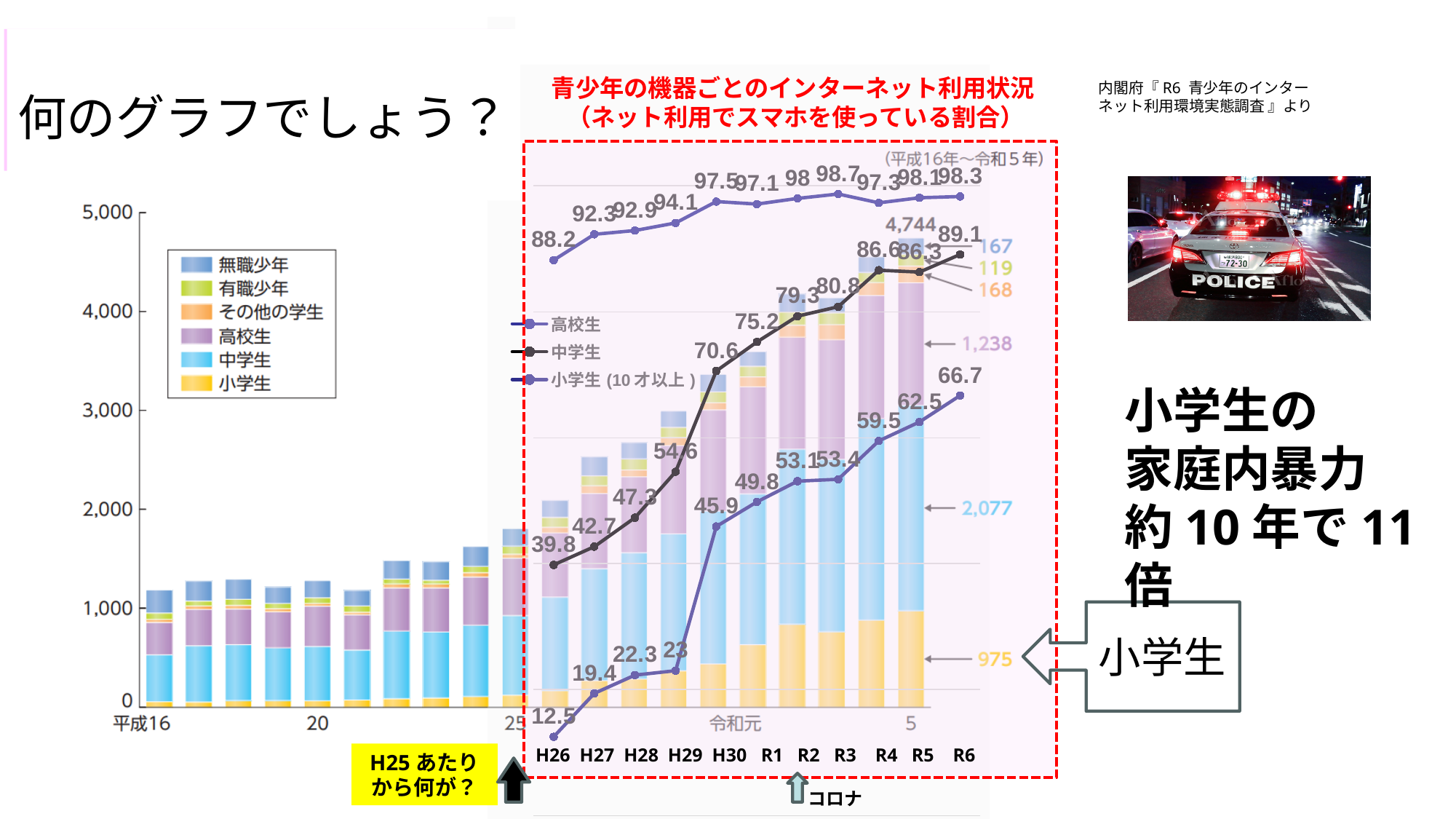
In the line chart titled 青少年の機器ごとのインターネット利用状況, what is the value for 中学生 at R6? 89.1 In the line chart titled 青少年の機器ごとのインターネット利用状況, what is the value for 中学生 at H30? 70.6 In the line chart titled 青少年の機器ごとのインターネット利用状況, what is the value for 小学生 at R6? 66.7 In the stacked bar chart on the left, what is the total of the last (rightmost) bar? 4,744 In the stacked bar chart on the left, is the total for 平成16 greater or less than 2,000? less In the line chart titled 青少年の機器ごとのインターネット利用状況, what is the value for 高校生 at H26? 88.2 In the line chart titled 青少年の機器ごとのインターネット利用状況, do the values for 小学生 rise or fall from H26 to R6? rise In the line chart titled 青少年の機器ごとのインターネット利用状況, what is the difference between the 高校生 and 小学生 values at H26? 75.7 How many entries does the legend of the stacked bar chart on the left list? 6 In the stacked bar chart on the left, what is the value of the 中学生 segment in the last bar? 2,077 In the line chart titled 青少年の機器ごとのインターネット利用状況, which series has the highest value at R6? 高校生 How many series does the legend of the line chart titled 青少年の機器ごとのインターネット利用状況 list? 3